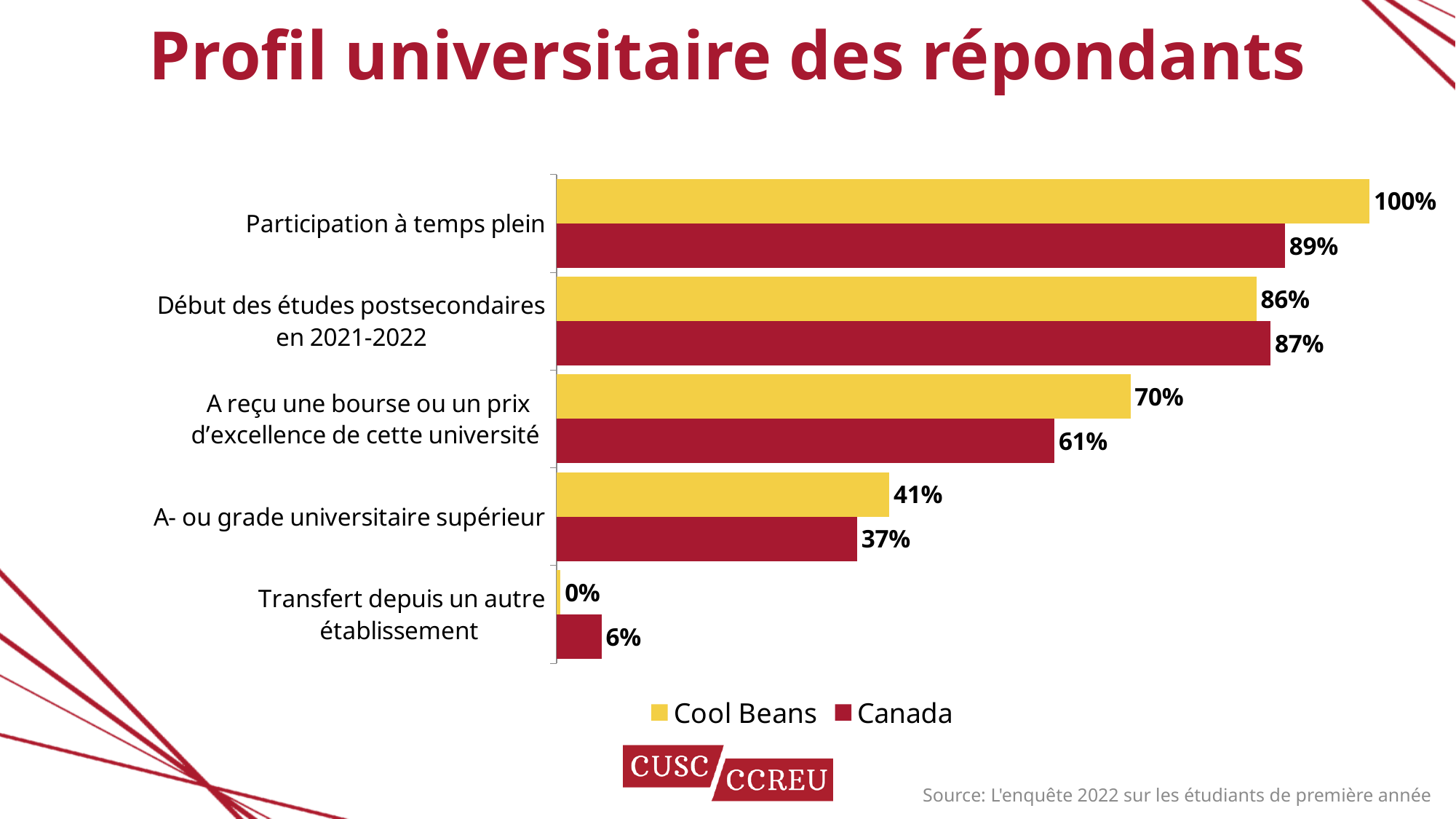
How many categories are shown in the chart? 5 How many series does the legend list? 2 What is the Cool Beans value for "Participation à temps plein"? 100% What is the Canada value for "A reçu une bourse ou un prix d'excellence de cette université"? 61% What is the Cool Beans value for "A- ou grade universitaire supérieur"? 41% Which category has the lowest Cool Beans value? Transfert depuis un autre établissement What is the difference between the Cool Beans and Canada values for "Participation à temps plein"? 11% Which category has the highest Canada value? Participation à temps plein What is the difference between the Cool Beans and Canada values for "A reçu une bourse ou un prix d'excellence de cette université"? 9% What kind of chart is shown on the slide? Bar chart For "Début des études postsecondaires en 2021-2022", which series has the larger value, Cool Beans or Canada? Canada What is the Canada value for "Transfert depuis un autre établissement"? 6%